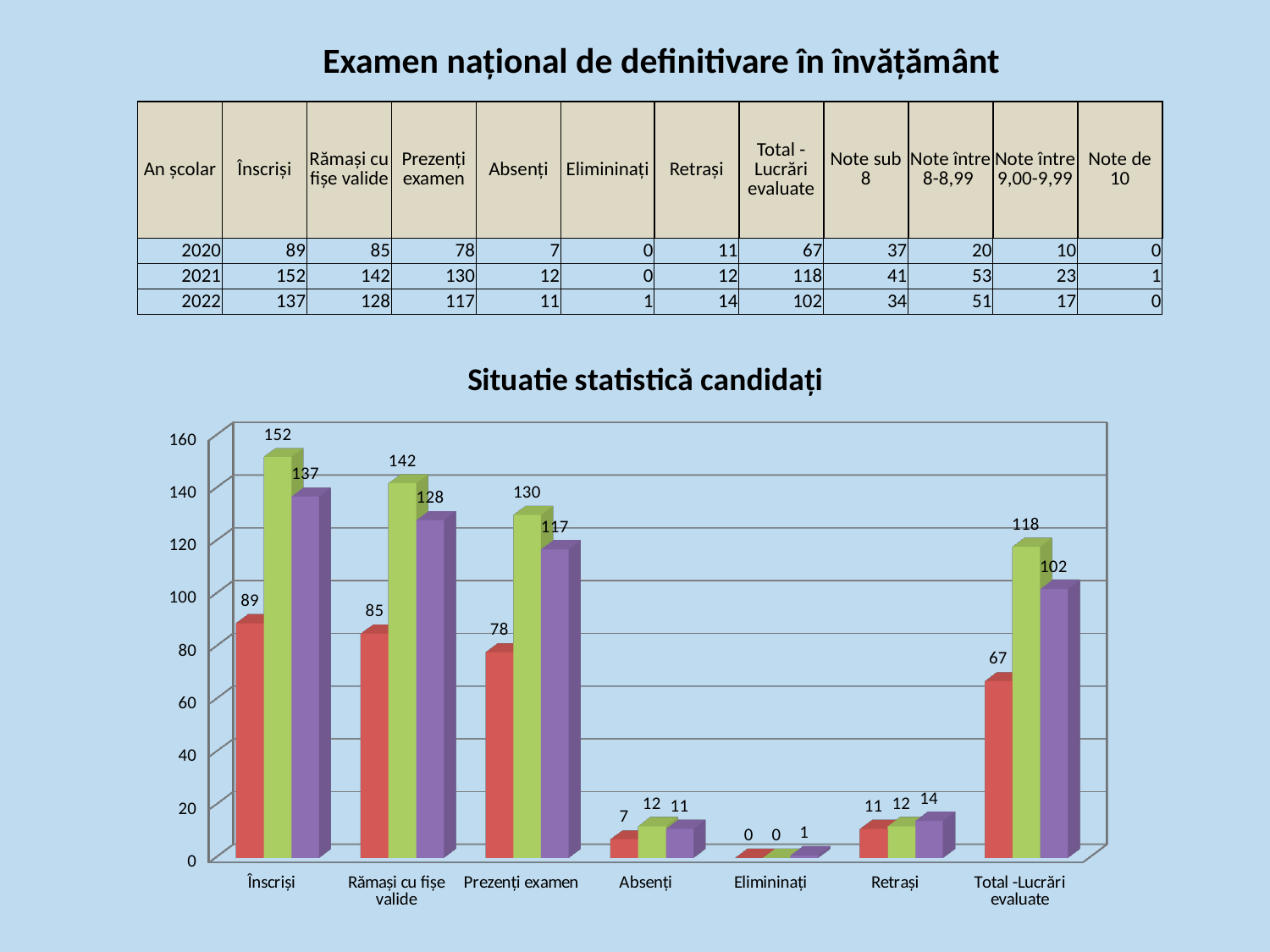
What is the value of the green bar for 'Înscriși'? 152 Which category has the lowest red bar? Elimininați What is the difference between the green bar and the red bar for 'Rămași cu fișe valide'? 57 How many categories are shown on the x axis of the chart? 7 What type of chart is shown under the title 'Situatie statistică candidați'? bar chart Is the value of the purple bar for 'Înscriși' greater or less than 120? greater What is the value of the purple bar for 'Total -Lucrări evaluate'? 102 What is the value of the green bar for 'Absenți'? 12 What is the title of the chart on the slide? Situatie statistică candidați Which category has the highest green bar? Înscriși Which is larger for 'Retrași': the purple bar or the red bar? the purple bar What is the value of the red bar for 'Prezenți examen'? 78